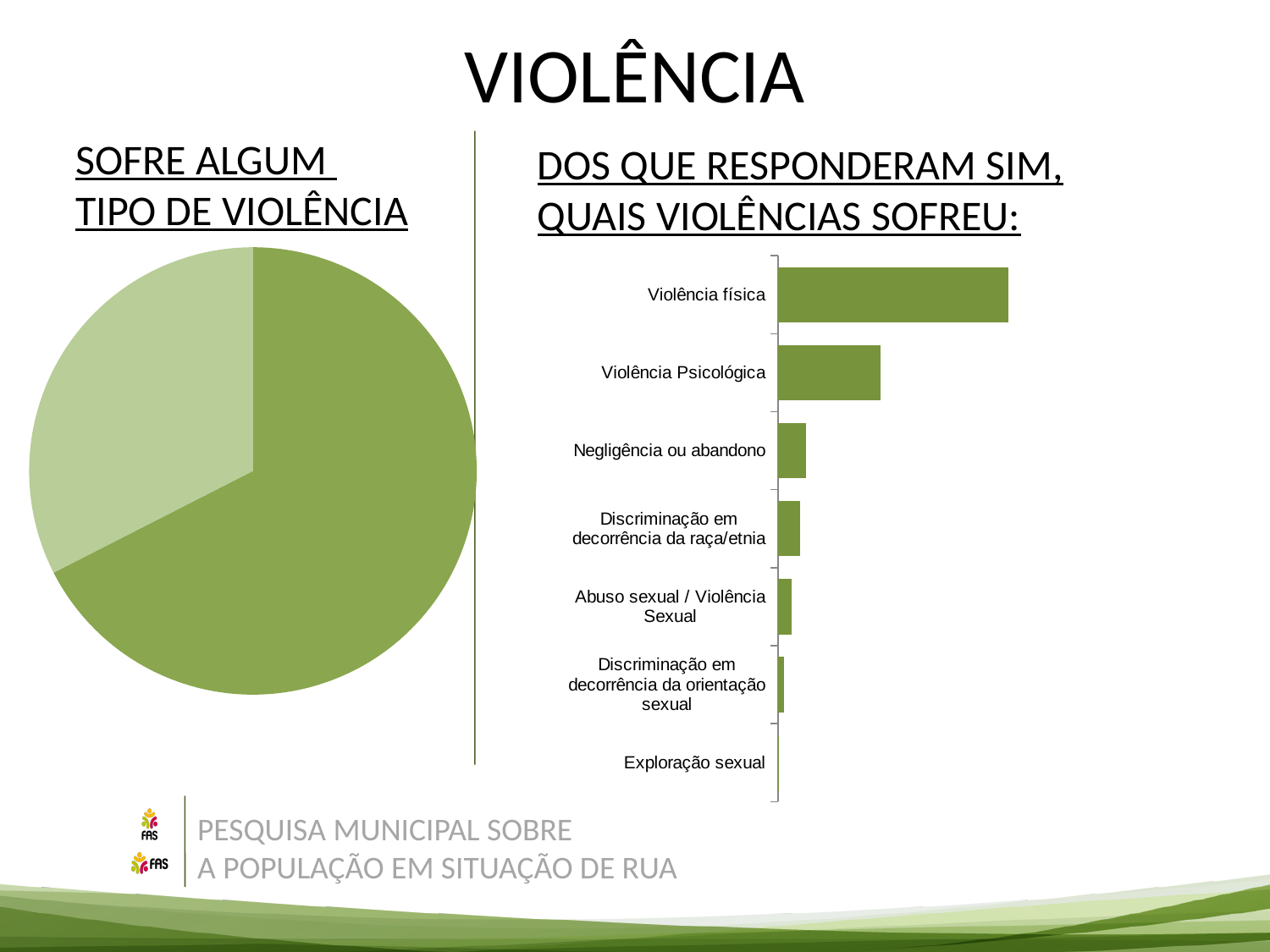
What kind of chart is shown on the left of the slide under "SOFRE ALGUM TIPO DE VIOLÊNCIA"? Pie chart In the bar chart on the right of the slide, which category has the highest value? Violência física In the bar chart on the right of the slide, which is larger: Violência física or Violência Psicológica? Violência física How many categories are listed in the bar chart on the right of the slide? 7 In the pie chart on the left of the slide, which slice is larger, the dark green one or the light green one? The dark green one In the bar chart on the right of the slide, which is larger: Negligência ou abandono or Abuso sexual / Violência Sexual? Negligência ou abandono What kind of chart is shown on the right of the slide under "DOS QUE RESPONDERAM SIM, QUAIS VIOLÊNCIAS SOFREU:"? Bar chart In the bar chart on the right of the slide, do the bar lengths increase or decrease going from the top category to the bottom category? Decrease What is the title of the bar chart on the right of the slide? DOS QUE RESPONDERAM SIM, QUAIS VIOLÊNCIAS SOFREU: In the bar chart on the right of the slide, which category has the lowest value? Exploração sexual How many slices does the pie chart on the left of the slide have? 2